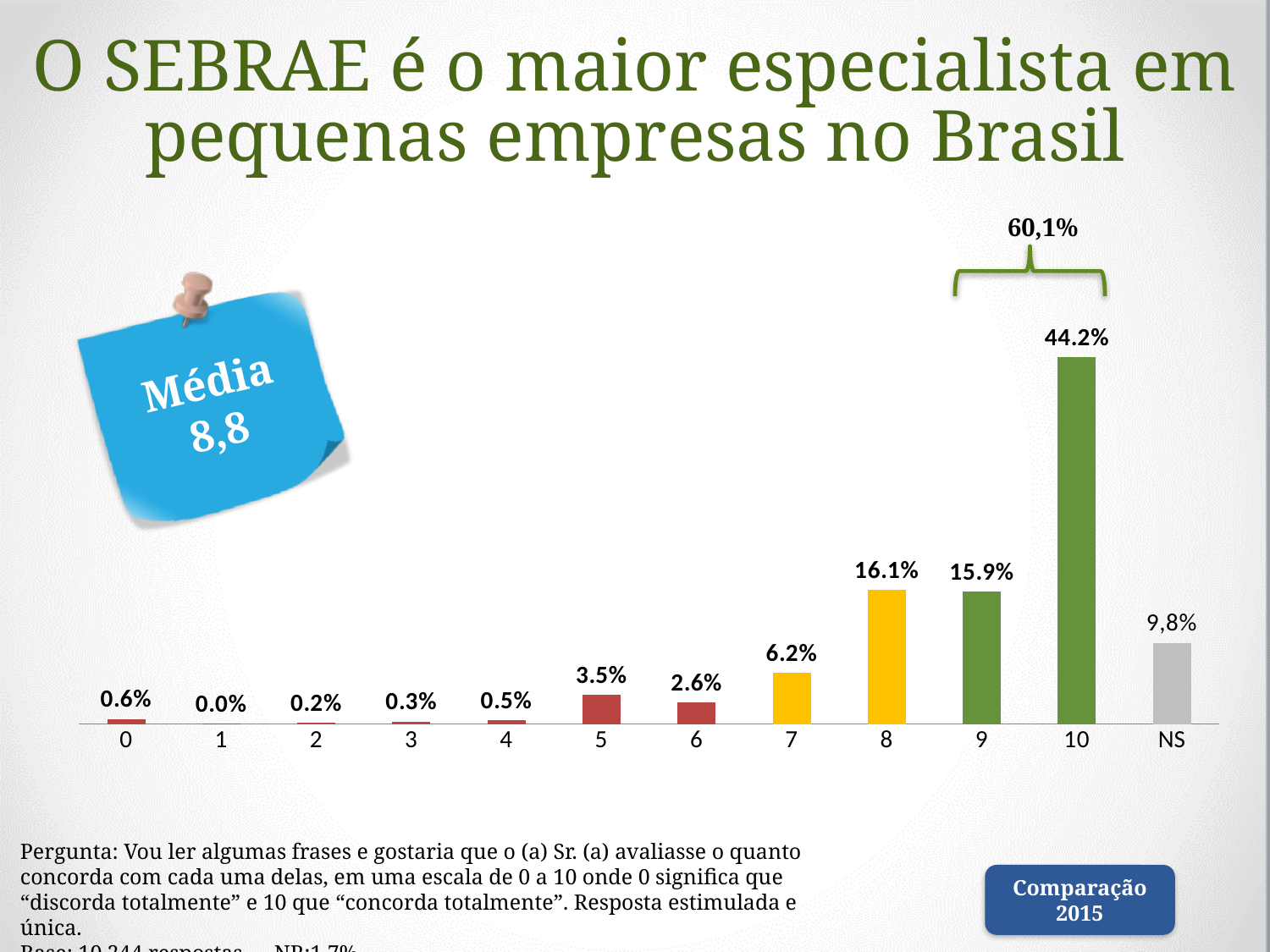
How many categories are shown on the x axis? 12 What percentage of respondents gave a score of 8? 16.1% What is the value shown for the NS category? 9,8% What percentage of respondents gave a score of 10? 44.2% Which score category has the lowest percentage? 1 What average (Média) is shown on the blue note? 8,8 Which is larger, the percentage for score 7 or for score 6? 7 What is the difference between the percentages for scores 8 and 9? 0.2% What combined percentage is shown by the bracket above scores 9 and 10? 60,1% What percentage of respondents gave a score of 5? 3.5% What type of chart is shown on the slide? bar chart Which score category has the highest percentage? 10